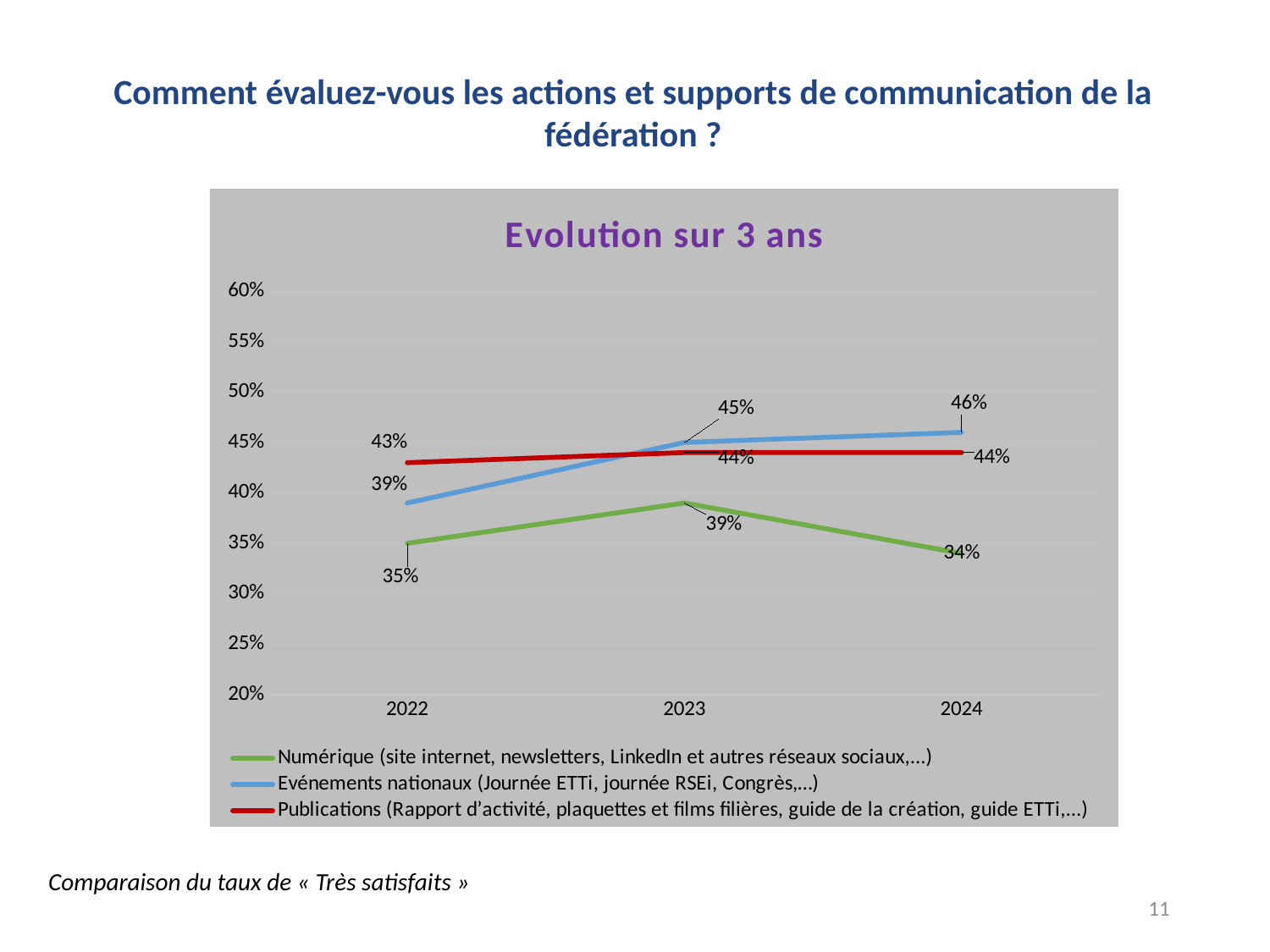
How many series does the legend list? 3 What kind of chart is shown on the slide? Line chart What is the title of the chart? Evolution sur 3 ans Which series has the highest value in 2024? Evénements nationaux Which series has the lowest value in 2023? Numérique What is the value for Publications in 2022? 43% Which is larger in 2022, the value for Publications or the value for Numérique? Publications Does the Evénements nationaux series rise or fall from 2022 to 2024? Rise How many years are shown on the x axis? 3 What is the difference between the Evénements nationaux value in 2023 and in 2022? 6% What is the value for Evénements nationaux in 2024? 46% What is the value for Numérique in 2022? 35%